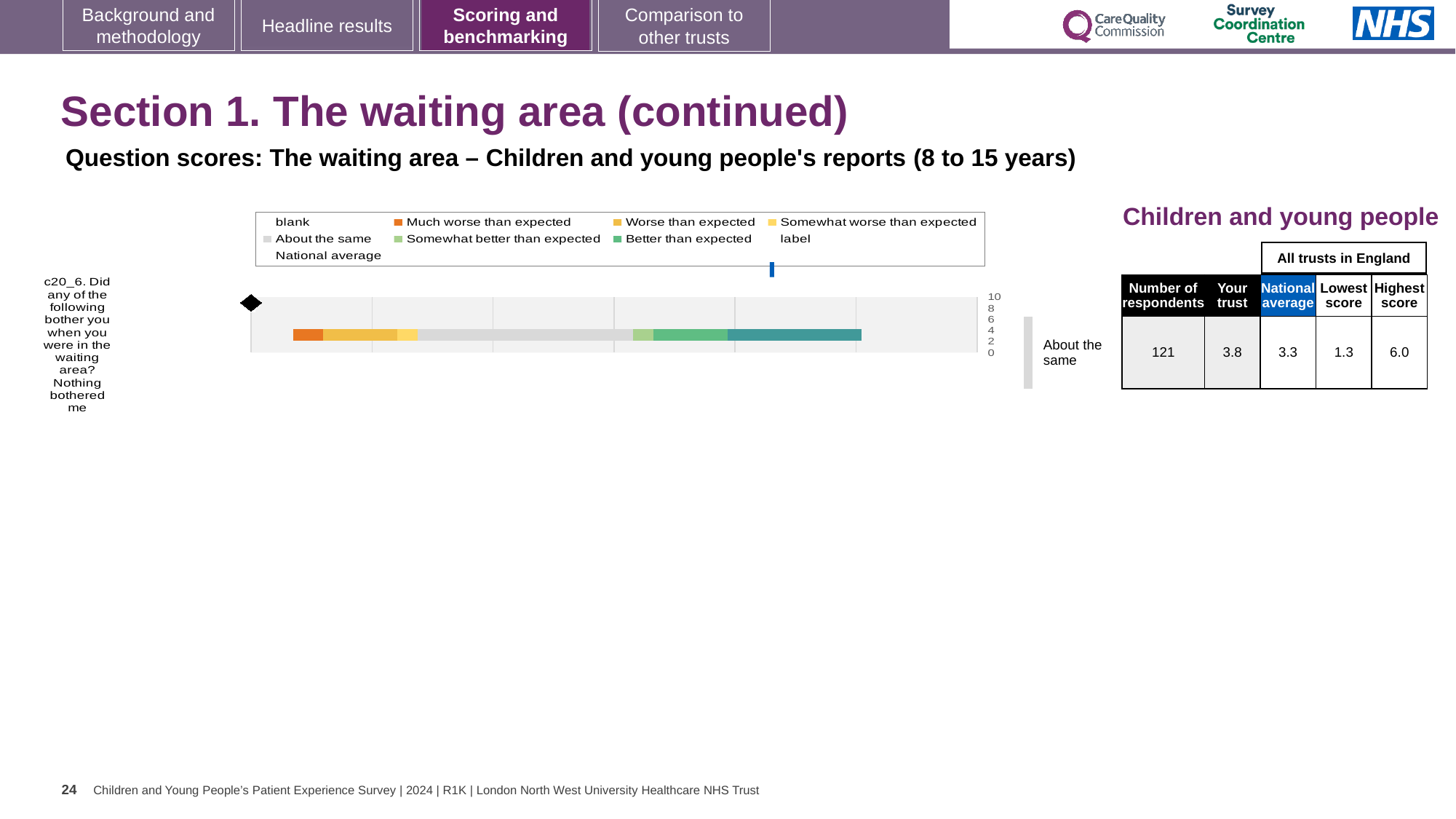
What benchmark category label is shown to the right of the bar for question c20_6? About the same How many entries does the chart legend list? 9 How many questions (categories) are plotted in the chart? 1 In the table next to the chart, what is the national average score? 3.3 In the table next to the chart, what is the 'Your trust' score for question c20_6? 3.8 In the table next to the chart, which is larger: the 'Your trust' score or the national average? Your trust Which legend entry is shown in orange? Much worse than expected In the table next to the chart, what is the difference between the highest score and the lowest score across all trusts in England? 4.7 In the table next to the chart, how many respondents are listed? 121 What kind of chart is shown on the slide? bar chart What is the highest value shown on the chart's numeric axis? 10